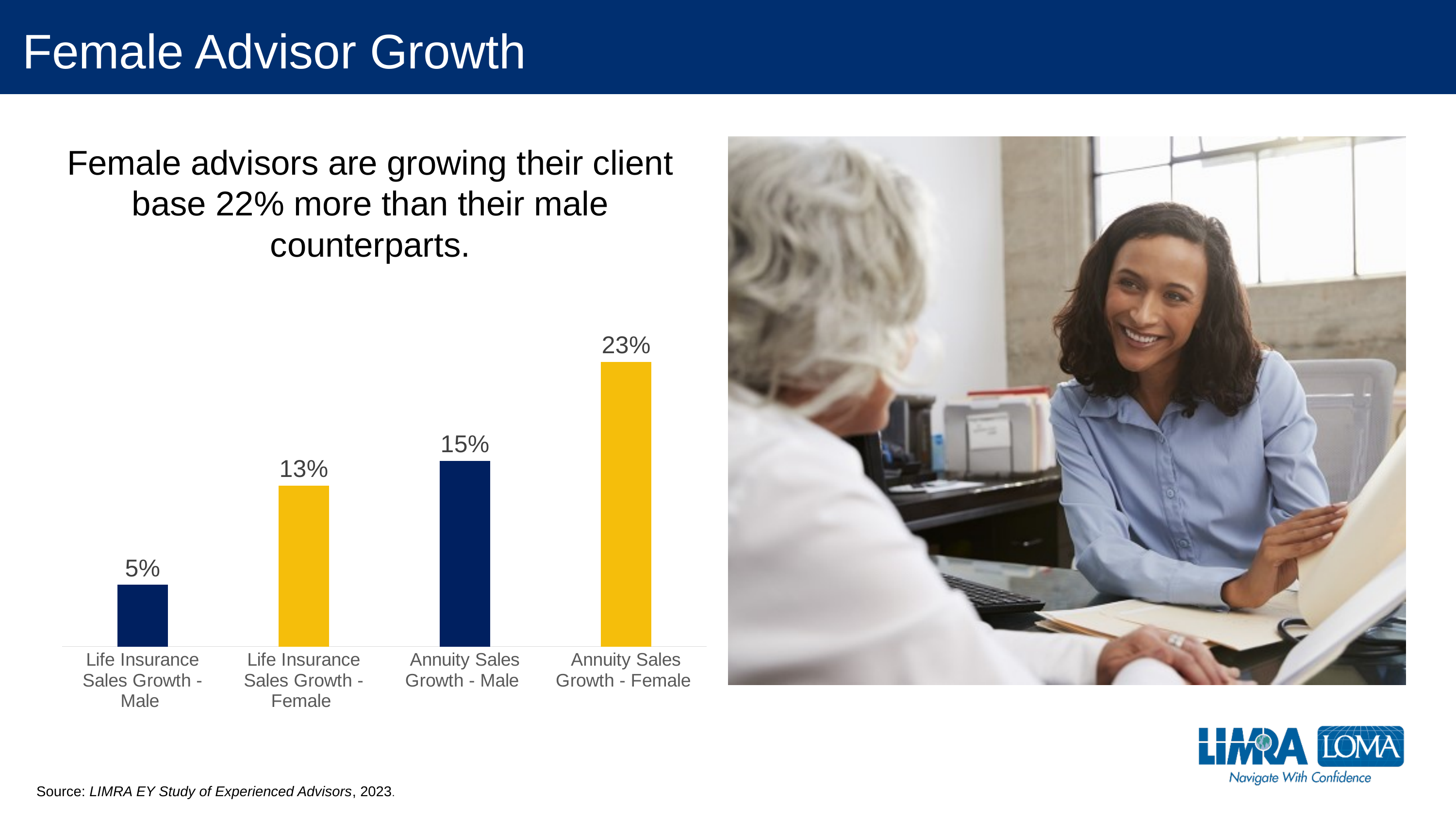
What is the value for Annuity Sales Growth - Female? 23% What is the value for Life Insurance Sales Growth - Male? 5% What is the difference between Life Insurance Sales Growth - Female and Life Insurance Sales Growth - Male? 8% What is the value for Annuity Sales Growth - Male? 15% Which category has the lowest value? Life Insurance Sales Growth - Male How many categories are shown in the chart? 4 Which is larger, Life Insurance Sales Growth - Female or Annuity Sales Growth - Male? Annuity Sales Growth - Male What colour are the bars for the Female categories? Yellow Which category has the highest value? Annuity Sales Growth - Female What kind of chart is shown on the slide? Bar chart What is the value for Life Insurance Sales Growth - Female? 13% What is the difference between Annuity Sales Growth - Female and Annuity Sales Growth - Male? 8%